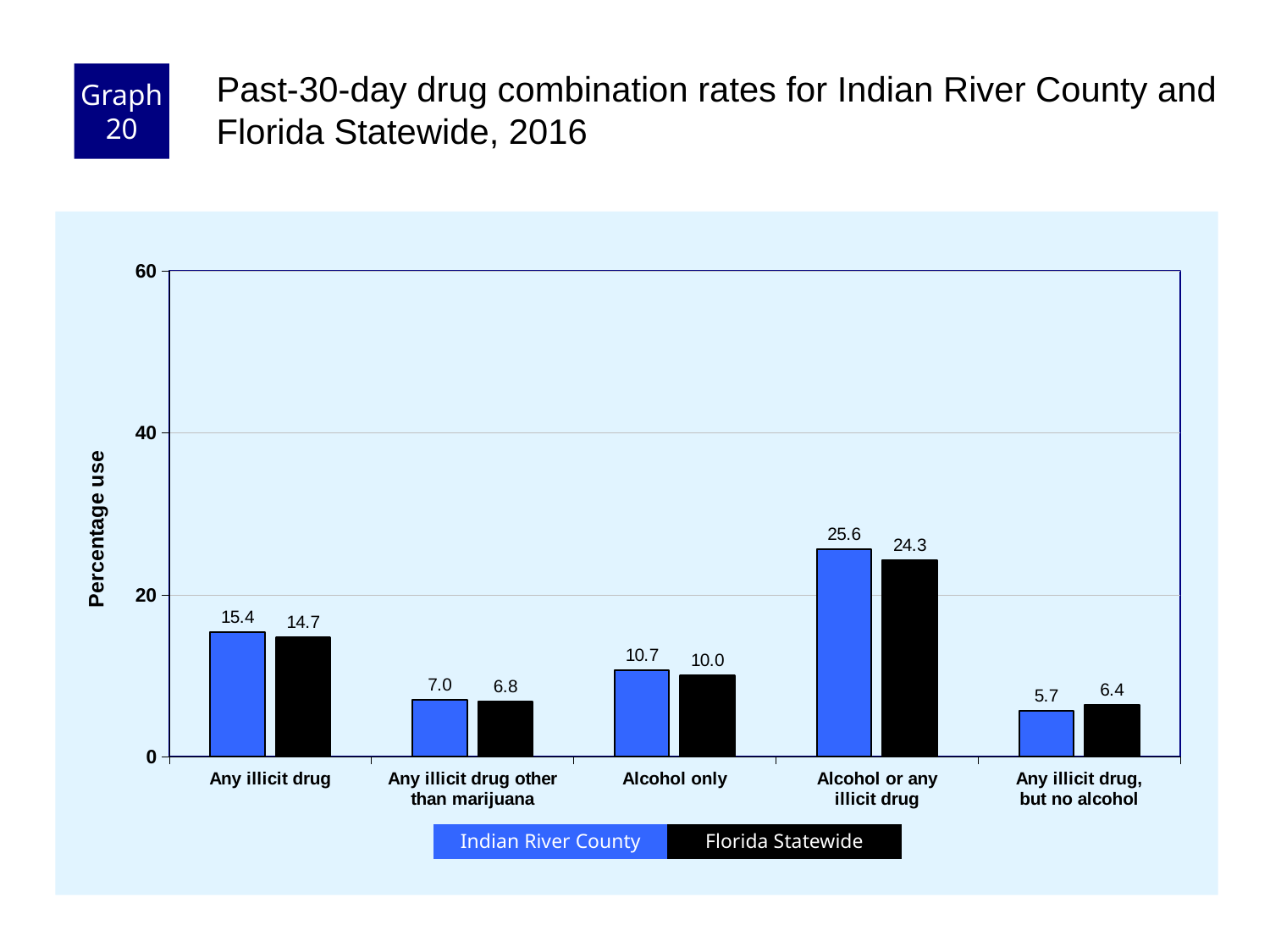
Which category has the lowest Indian River County value? Any illicit drug, but no alcohol What is the Florida Statewide value for Any illicit drug, but no alcohol? 6.4 What is the Indian River County value for Alcohol only? 10.7 Which category has the highest Florida Statewide value? Alcohol or any illicit drug How many categories are shown on the x axis? 5 What kind of chart is shown on the slide? bar chart What is the Indian River County value for Any illicit drug other than marijuana? 7.0 How many series does the legend list? 2 For Any illicit drug, which is larger: the Indian River County value or the Florida Statewide value? Indian River County What is the difference between the Indian River County and Florida Statewide values for Alcohol or any illicit drug? 1.3 Is the Florida Statewide value for Alcohol or any illicit drug greater or less than 20? greater What is the label of the y axis? Percentage use